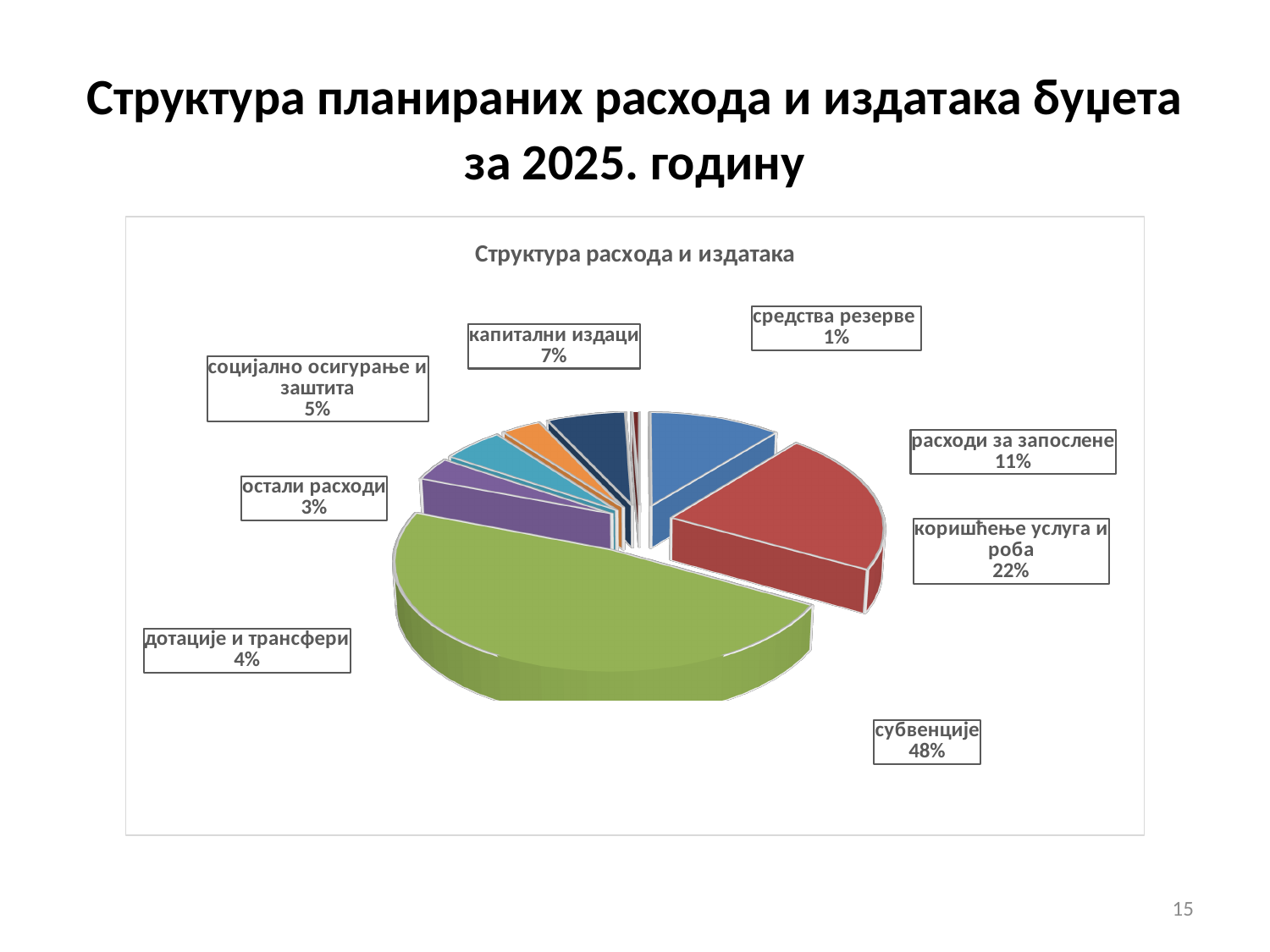
What share of the pie is labelled for средства резерве? 1% Which has a larger share, социјално осигурање и заштита or дотације и трансфери? социјално осигурање и заштита What share of the pie is labelled for коришћење услуга и роба? 22% What share of the pie is labelled for расходи за запослене? 11% What is the difference in percentage points between субвенције and коришћење услуга и роба? 26% How many slices does the pie chart have? 8 Which category has the smallest share of the pie? средства резерве Which category has the largest share of the pie? субвенције What is the title of the chart? Структура расхода и издатака What kind of chart is shown on the slide? pie chart